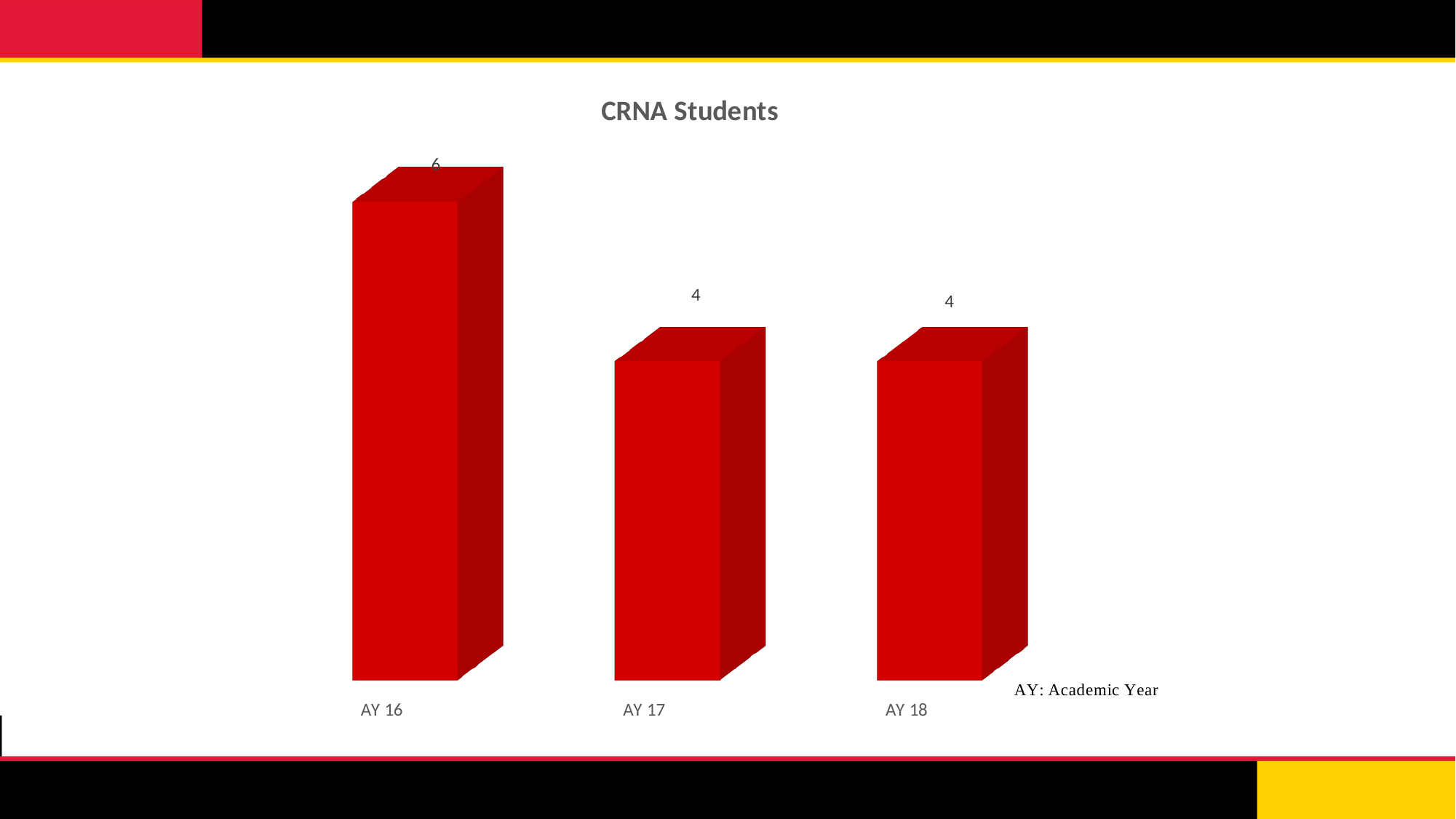
What is the value for AY 17? 4 What kind of chart is shown on the slide? bar chart What is the value for AY 18? 4 Which academic year has the highest number of CRNA students? AY 16 What is the title of the chart? CRNA Students How many categories are shown on the x axis? 3 Do the values rise or fall from AY 16 to AY 17? fall What is the difference between the values for AY 16 and AY 17? 2 What is the value for AY 16? 6 What does the note on the slide say AY stands for? Academic Year What is the total of the values for AY 17 and AY 18? 8 Which is larger, the value for AY 16 or the value for AY 18? AY 16